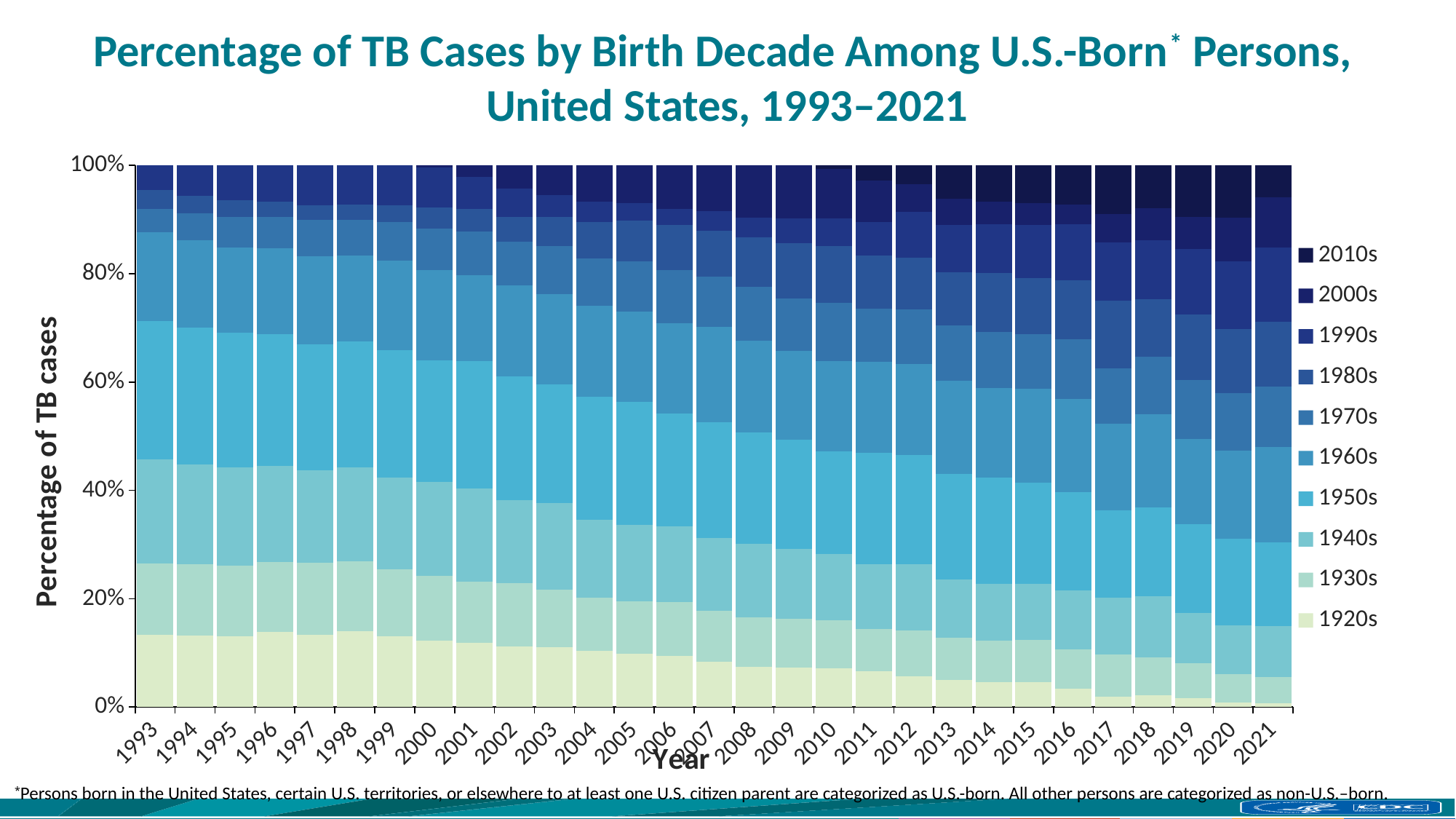
Is the 1920s share of TB cases in 2021 greater or less than 20%? less Which birth decade is listed first (at the top) in the legend? 2010s What kind of chart is shown on the slide? stacked bar chart What is the total height of each stacked bar in the chart? 100% Does the 1920s share of TB cases rise or fall from 1993 to 2021? fall How many birth-decade series does the legend list? 10 Which year has the larger 1920s share of TB cases, 1993 or 2021? 1993 What is the label on the y axis of the chart? Percentage of TB cases How many years are shown along the x axis of the chart? 29 Is the 1920s share of TB cases in 1993 greater or less than 20%? less